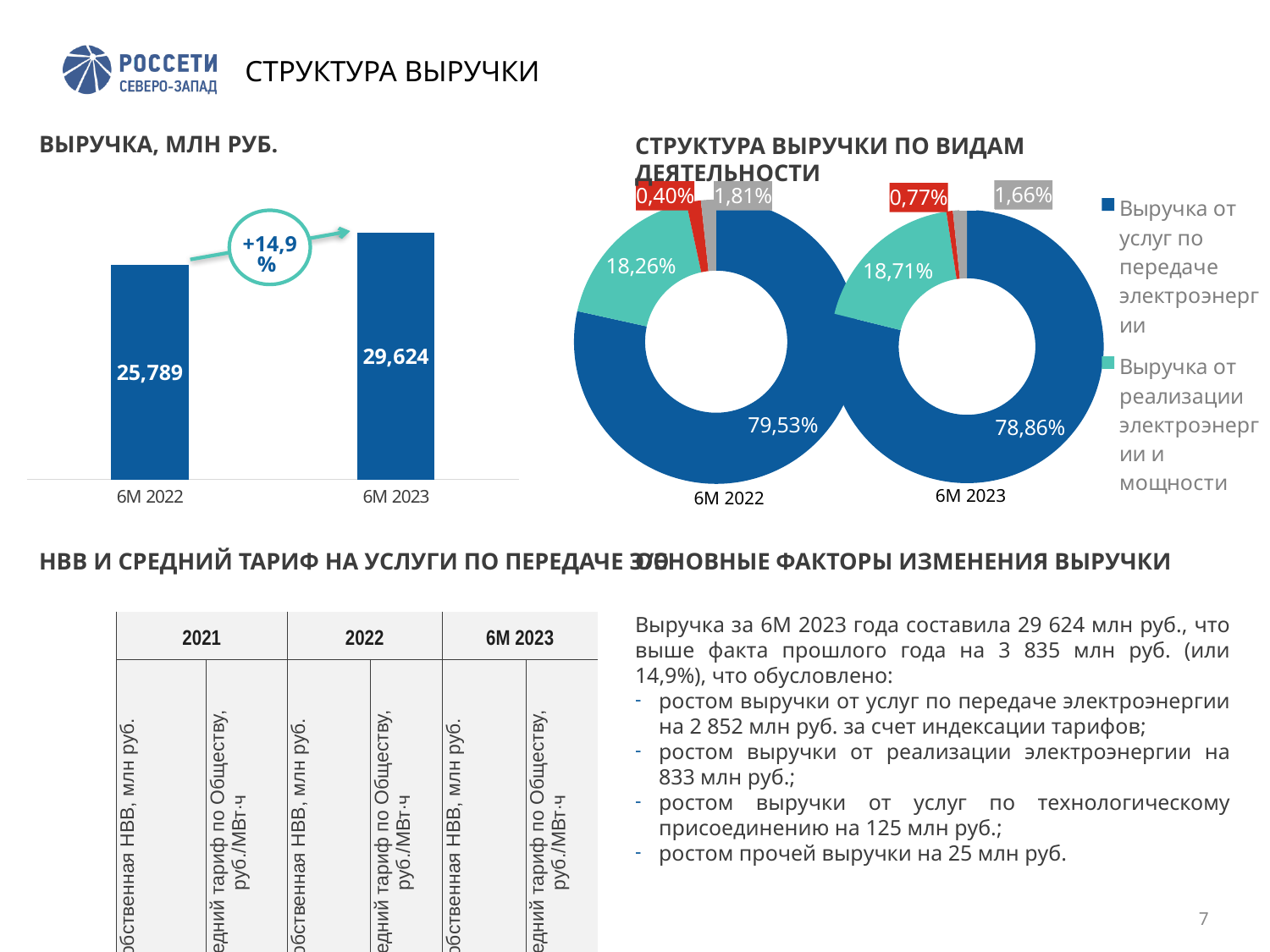
In the chart 'ВЫРУЧКА, МЛН РУБ.', what is the value for 6M 2023? 29,624 In the 'СТРУКТУРА ВЫРУЧКИ ПО ВИДАМ ДЕЯТЕЛЬНОСТИ' chart for 6M 2022, which segment is the largest? Выручка от услуг по передаче электроэнергии In the chart 'ВЫРУЧКА, МЛН РУБ.', what percentage change is shown between the two bars? +14,9% In the chart 'ВЫРУЧКА, МЛН РУБ.', what is the value for 6M 2022? 25,789 In the 'СТРУКТУРА ВЫРУЧКИ ПО ВИДАМ ДЕЯТЕЛЬНОСТИ' chart, what share does 'Выручка от услуг по передаче электроэнергии' have in 6M 2023? 78,86% In the 'СТРУКТУРА ВЫРУЧКИ ПО ВИДАМ ДЕЯТЕЛЬНОСТИ' chart, what share does 'Выручка от реализации электроэнергии и мощности' have in 6M 2023? 18,71% How many bars are in the chart 'ВЫРУЧКА, МЛН РУБ.'? 2 In the chart 'ВЫРУЧКА, МЛН РУБ.', what is the difference between the 6M 2023 and 6M 2022 values? 3,835 In the chart 'ВЫРУЧКА, МЛН РУБ.', which period has the higher value, 6M 2022 or 6M 2023? 6M 2023 What type of chart is 'СТРУКТУРА ВЫРУЧКИ ПО ВИДАМ ДЕЯТЕЛЬНОСТИ'? Donut (pie) chart In the 'СТРУКТУРА ВЫРУЧКИ ПО ВИДАМ ДЕЯТЕЛЬНОСТИ' chart, what share does 'Выручка от услуг по передаче электроэнергии' have in 6M 2022? 79,53% What type of chart is 'ВЫРУЧКА, МЛН РУБ.'? Bar chart